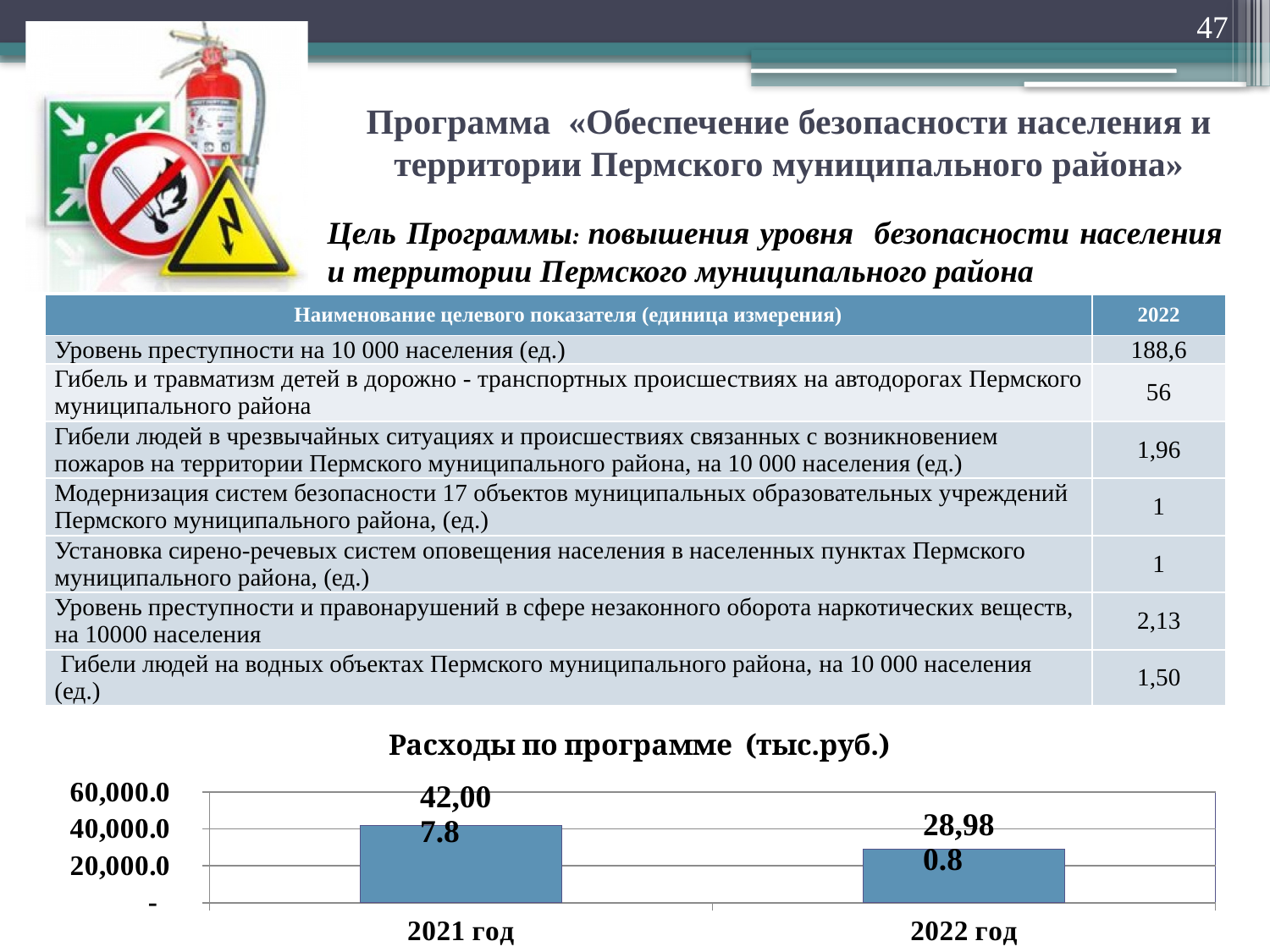
Which year has the highest expenditure in the 'Расходы по программе' chart? 2021 год In the 'Расходы по программе' chart, is the value for 2022 год greater or less than 20,000.0? greater What is the title of the bar chart at the bottom of the slide? Расходы по программе (тыс.руб.) In the 'Расходы по программе' chart, is the value for 2021 год greater or less than 20,000.0? greater What is the data label value for 2021 год in the 'Расходы по программе' chart? 42,007.8 In the 'Расходы по программе' chart, is the value for 2022 год greater or less than 40,000.0? less What is the data label value for 2022 год in the 'Расходы по программе' chart? 28,980.8 What kind of chart is used to show 'Расходы по программе (тыс.руб.)'? bar chart Which year has the lowest expenditure in the 'Расходы по программе' chart? 2022 год In the 'Расходы по программе' chart, which is larger: the value for 2021 год or for 2022 год? 2021 год How many years (categories) are shown in the 'Расходы по программе' chart? 2 Do the values in the 'Расходы по программе' chart rise or fall from 2021 год to 2022 год? fall